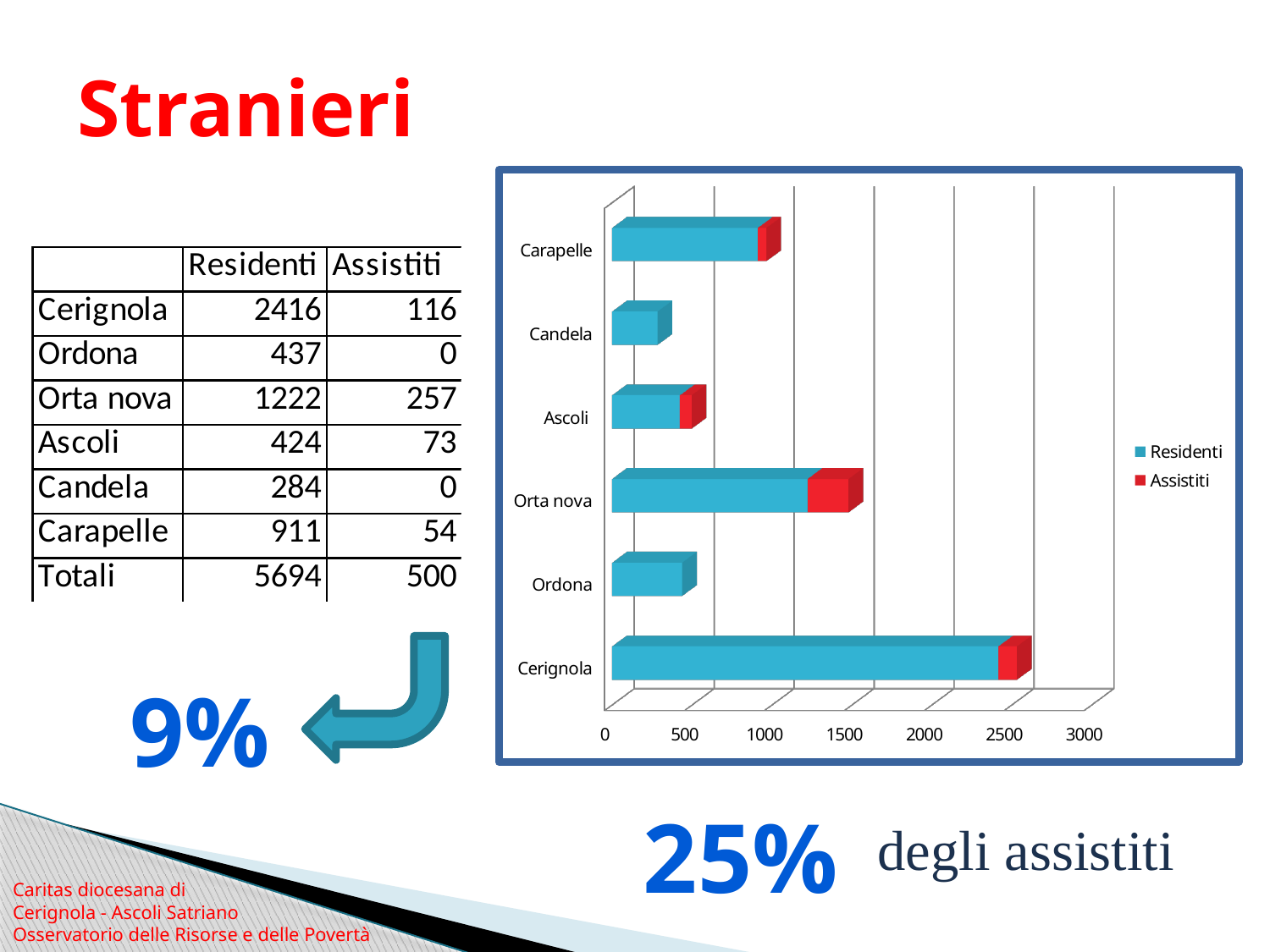
How many categories (towns) are plotted on the chart? 6 Which town has the highest Residenti value in the chart? Cerignola Is the Residenti value for Cerignola greater or less than 2000? greater What is the difference between the Residenti values of Cerignola and Orta nova? 1194 What is the Residenti value for Orta nova? 1222 How many series does the chart legend list? 2 Which town has the lowest Residenti value in the chart? Candela What kind of chart is shown on the slide? Stacked bar chart Which series is shown in red in the chart? Assistiti What is the total of the stacked bar for Cerignola (Residenti plus Assistiti)? 2532 What is the Assistiti value for Carapelle? 54 Which is larger, the Residenti value for Ordona or for Ascoli? Ordona